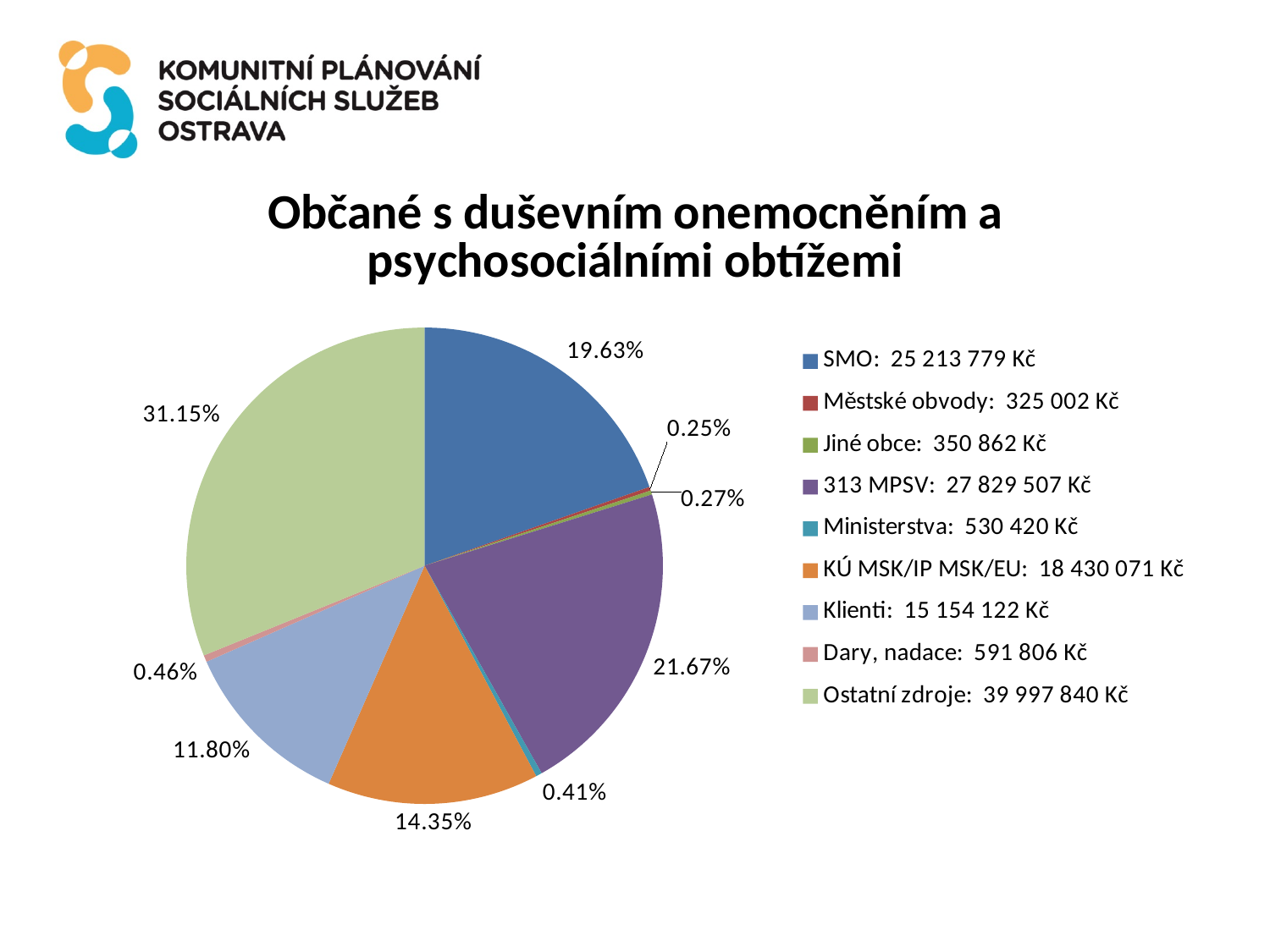
What share of the pie does 313 MPSV represent? 21.67% Which category has the largest slice of the pie? Ostatní zdroje What share of the pie does SMO represent? 19.63% What share of the pie does Klienti represent? 11.80% What amount in Kč does the legend show for KÚ MSK/IP MSK/EU? 18 430 071 Kč Which slice is larger, KÚ MSK/IP MSK/EU or Klienti? KÚ MSK/IP MSK/EU What is the difference in percentage points between the Ostatní zdroje slice and the 313 MPSV slice? 9.48 What amount in Kč does the legend show for Dary, nadace? 591 806 Kč How many slices does the pie chart have? 9 What type of chart is shown on the slide? pie chart Which category has the smallest slice of the pie? Městské obvody